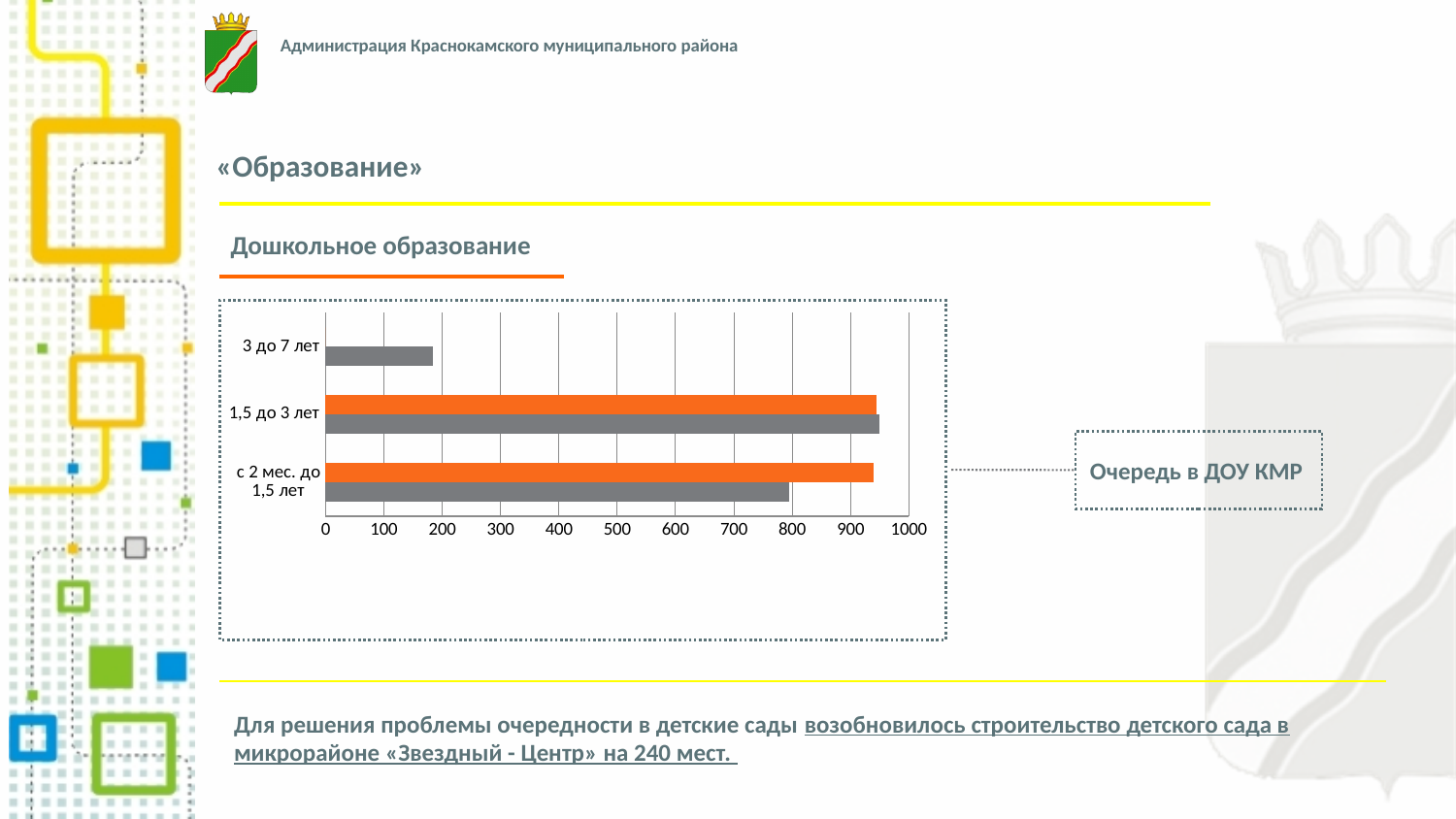
What label is shown in the box to the right of the chart? Очередь в ДОУ КМР Which is larger: the gray bar for "3 до 7 лет" or the gray bar for "1,5 до 3 лет"? 1,5 до 3 лет Is the gray bar for "с 2 мес. до 1,5 лет" greater or less than 900? less Is the gray bar for "3 до 7 лет" greater or less than 300? less Is the gray bar for "с 2 мес. до 1,5 лет" greater or less than 700? greater Which category has the shortest gray bar? 3 до 7 лет For "с 2 мес. до 1,5 лет", which bar is longer: the orange bar or the gray bar? the orange bar What kind of chart is shown on the slide? bar chart How many age categories are shown on the chart's vertical axis? 3 Which category has the longest gray bar? 1,5 до 3 лет What is the highest value shown on the chart's horizontal axis? 1000